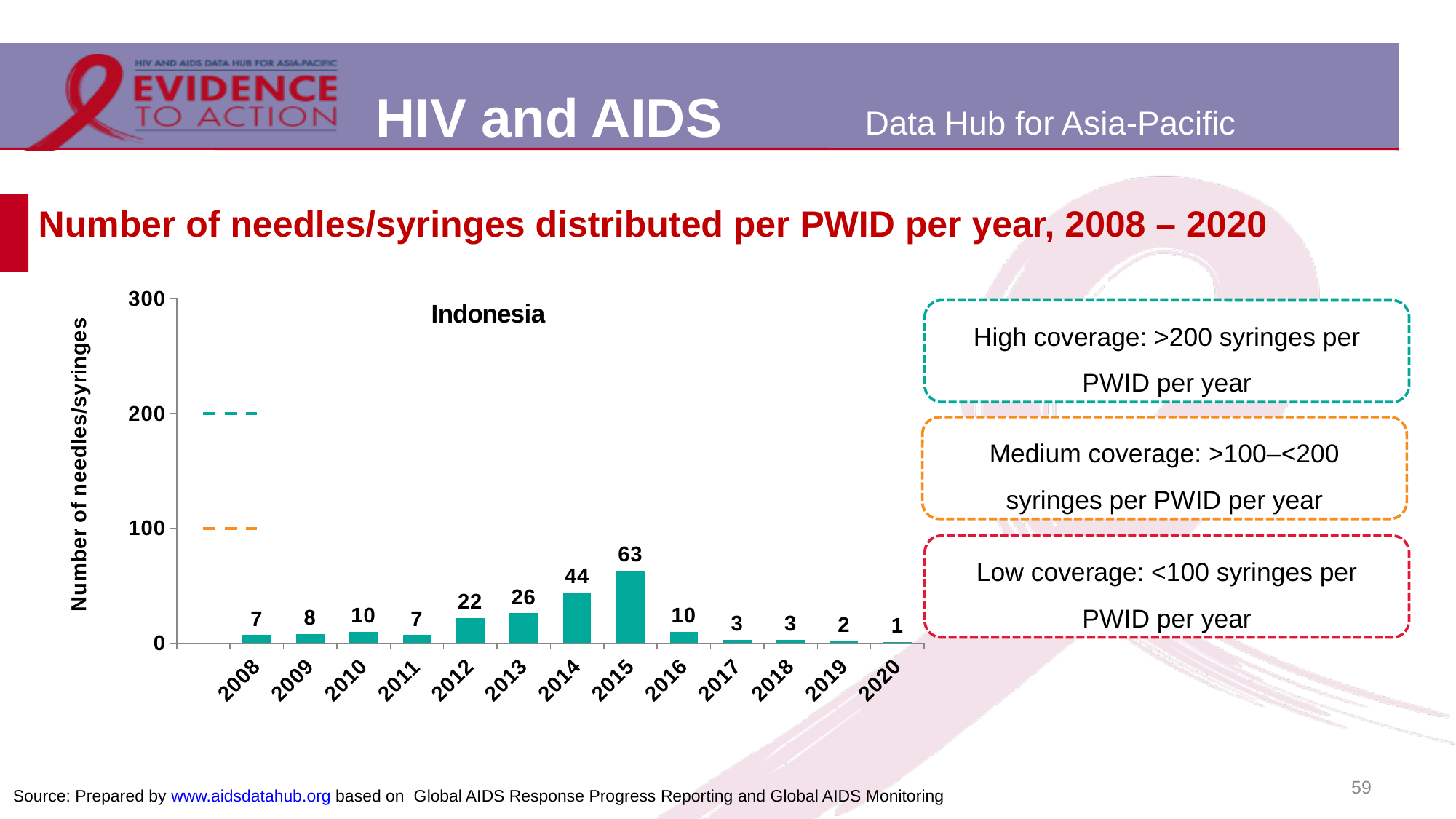
Which year has the highest number of needles/syringes distributed per PWID in Indonesia? 2015 Do the values rise or fall from 2015 to 2020? fall What is the number of needles/syringes distributed per PWID in Indonesia in 2015? 63 Which year has the lowest number of needles/syringes distributed per PWID in Indonesia? 2020 How many years are shown on the x axis of the chart? 13 What is the number of needles/syringes distributed per PWID in Indonesia in 2020? 1 Is the value for 2015 greater or less than 100? less What is the difference between the values for 2015 and 2014? 19 What is the number of needles/syringes distributed per PWID in Indonesia in 2012? 22 What is the label on the y axis of the chart? Number of needles/syringes Which year has a larger value, 2013 or 2016? 2013 What kind of chart is shown on the slide? bar chart